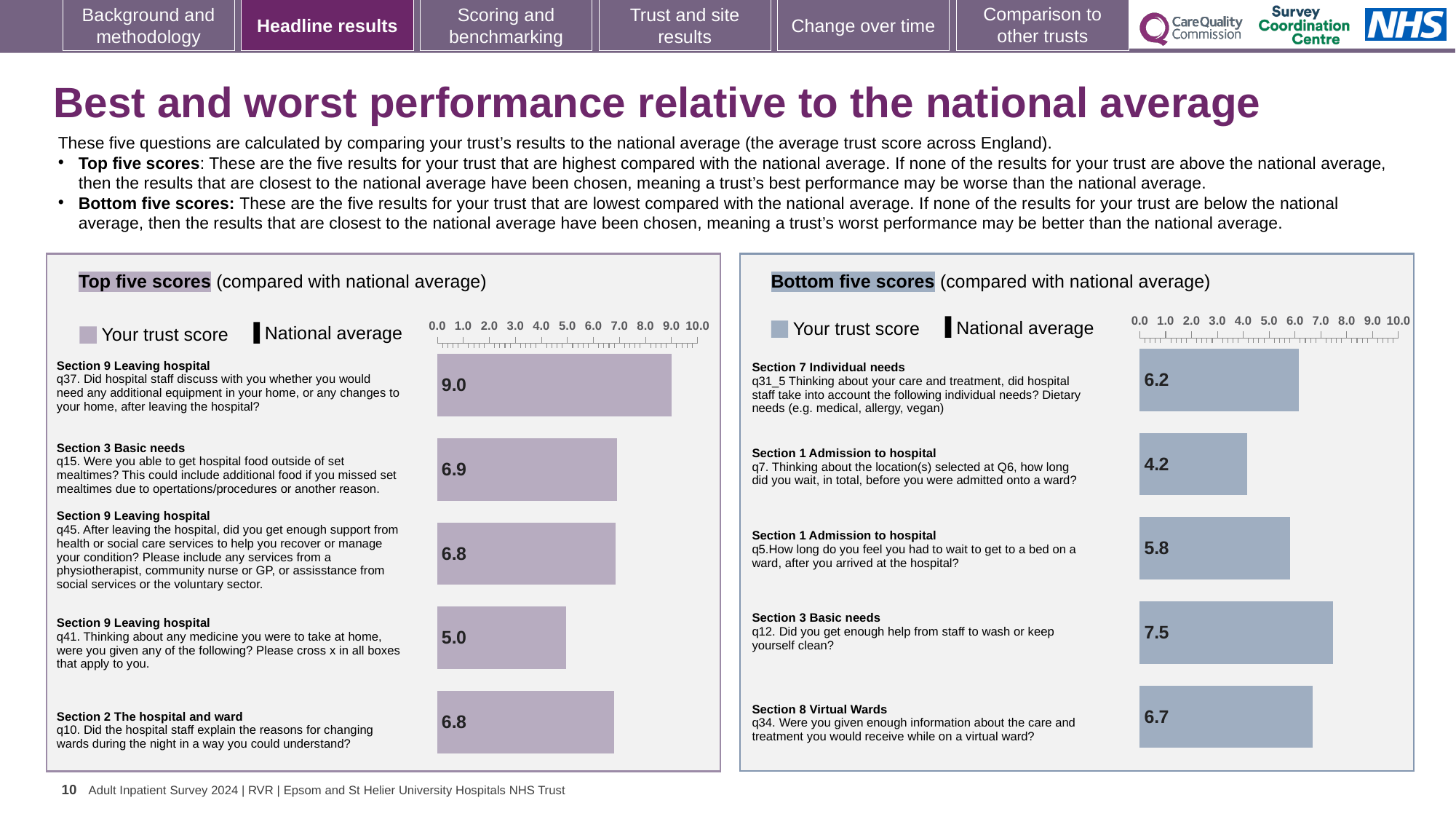
In the Top five scores chart, which question has the highest trust score? q37 How many bars are plotted in the Top five scores chart? 5 In the Bottom five scores chart, which question has the highest trust score? q12 In the Top five scores chart, what is the trust score for q37 (Section 9 Leaving hospital, discussing additional equipment or changes to your home)? 9.0 In the Bottom five scores chart, what is the difference between the trust scores for q34 and q7? 2.5 In the Top five scores chart, what is the difference between the trust scores for q37 and q41? 4.0 In the Top five scores chart, what is the trust score for q15 (Section 3 Basic needs, hospital food outside of set mealtimes)? 6.9 In the Bottom five scores chart, what is the trust score for q7 (Section 1 Admission to hospital, how long did you wait before being admitted onto a ward)? 4.2 What kind of chart is used for the Bottom five scores? Bar chart In the Bottom five scores chart, which is larger, the trust score for q31_5 or for q5? q31_5 In the Top five scores chart, which question has the lowest trust score? q41 In the Bottom five scores chart, what is the trust score for q12 (Section 3 Basic needs, help from staff to wash or keep yourself clean)? 7.5